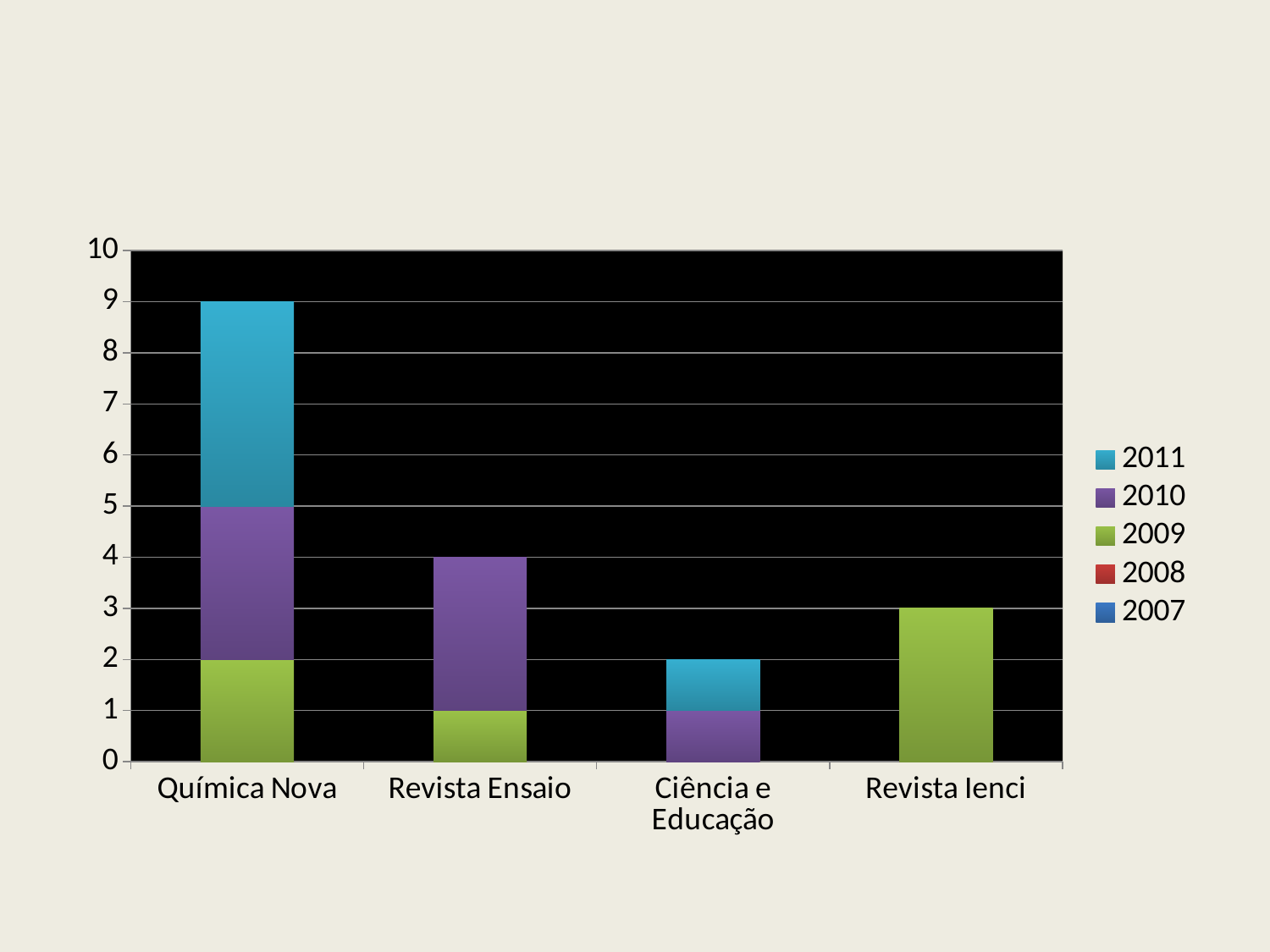
What is the value for 2009 in the Química Nova bar? 2 What is the value for 2009 in the Revista Ienci bar? 3 How many series does the legend list? 5 Which category has the tallest stacked bar? Química Nova Is the total for Química Nova greater or less than 5? greater What kind of chart is shown on the slide? stacked bar chart Which category has the shortest stacked bar? Ciência e Educação What is the total height of the stacked bar for Revista Ensaio? 4 What is the total height of the stacked bar for Química Nova? 9 Which legend entry is shown in green? 2009 How many categories are shown on the x axis? 4 What is the total height of the stacked bar for Ciência e Educação? 2